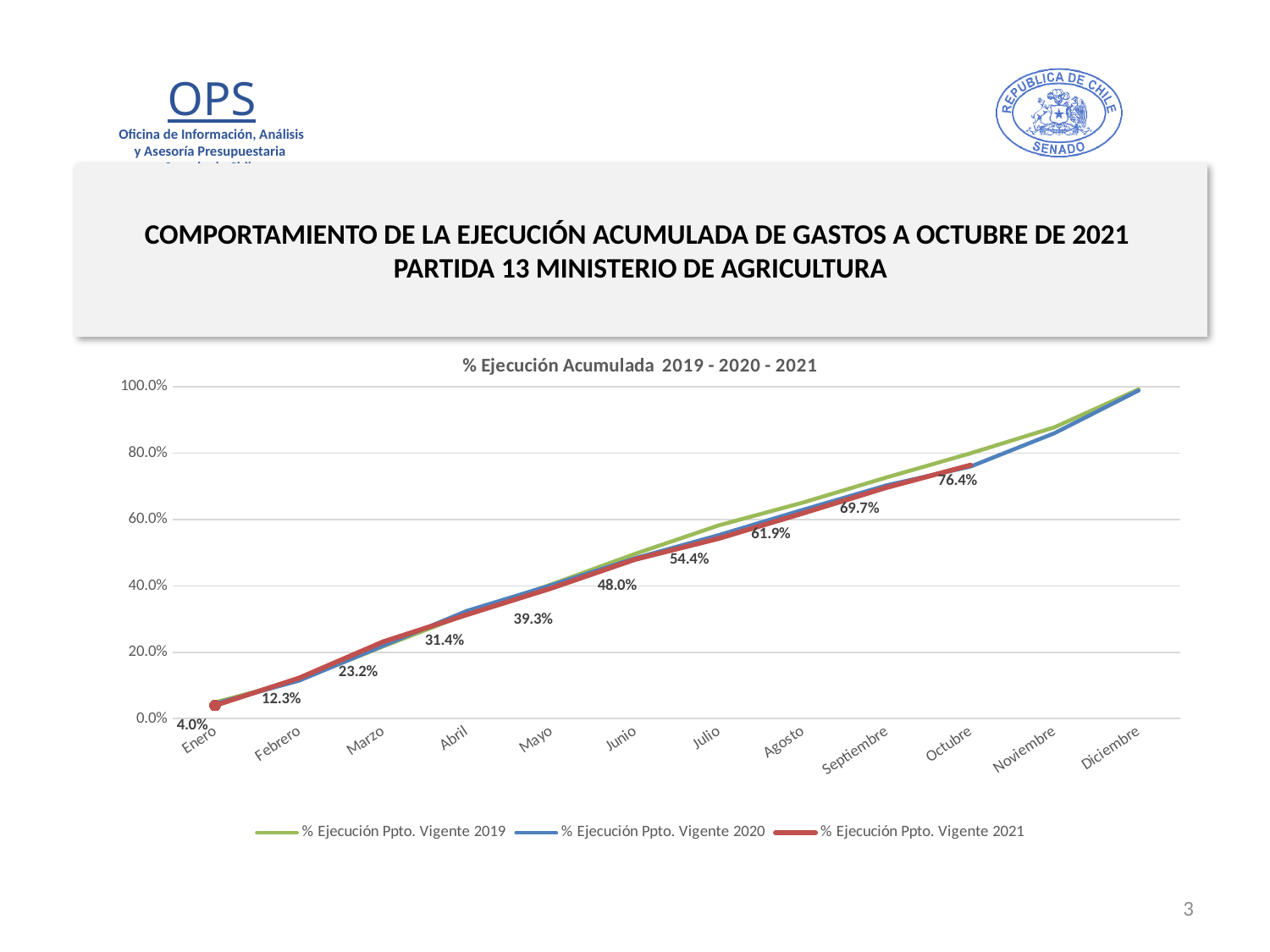
What is the value for % Ejecución Ppto. Vigente 2021 in Enero? 4.0% How many series does the legend list? 3 What is the difference between the 2021 values for Octubre and Septiembre? 6.7% What kind of chart is shown on the slide? line chart What is the value for % Ejecución Ppto. Vigente 2021 in Marzo? 23.2% Does the % Ejecución Ppto. Vigente 2021 series rise or fall from Enero to Octubre? rise Which month has the lowest value for % Ejecución Ppto. Vigente 2021? Enero Is the value for % Ejecución Ppto. Vigente 2020 in Diciembre greater or less than 80.0%? greater What is the value for % Ejecución Ppto. Vigente 2021 in Junio? 48.0% What is the value for % Ejecución Ppto. Vigente 2021 in Octubre? 76.4% How many months are shown on the x axis? 12 What is the title of the chart? % Ejecución Acumulada 2019 - 2020 - 2021